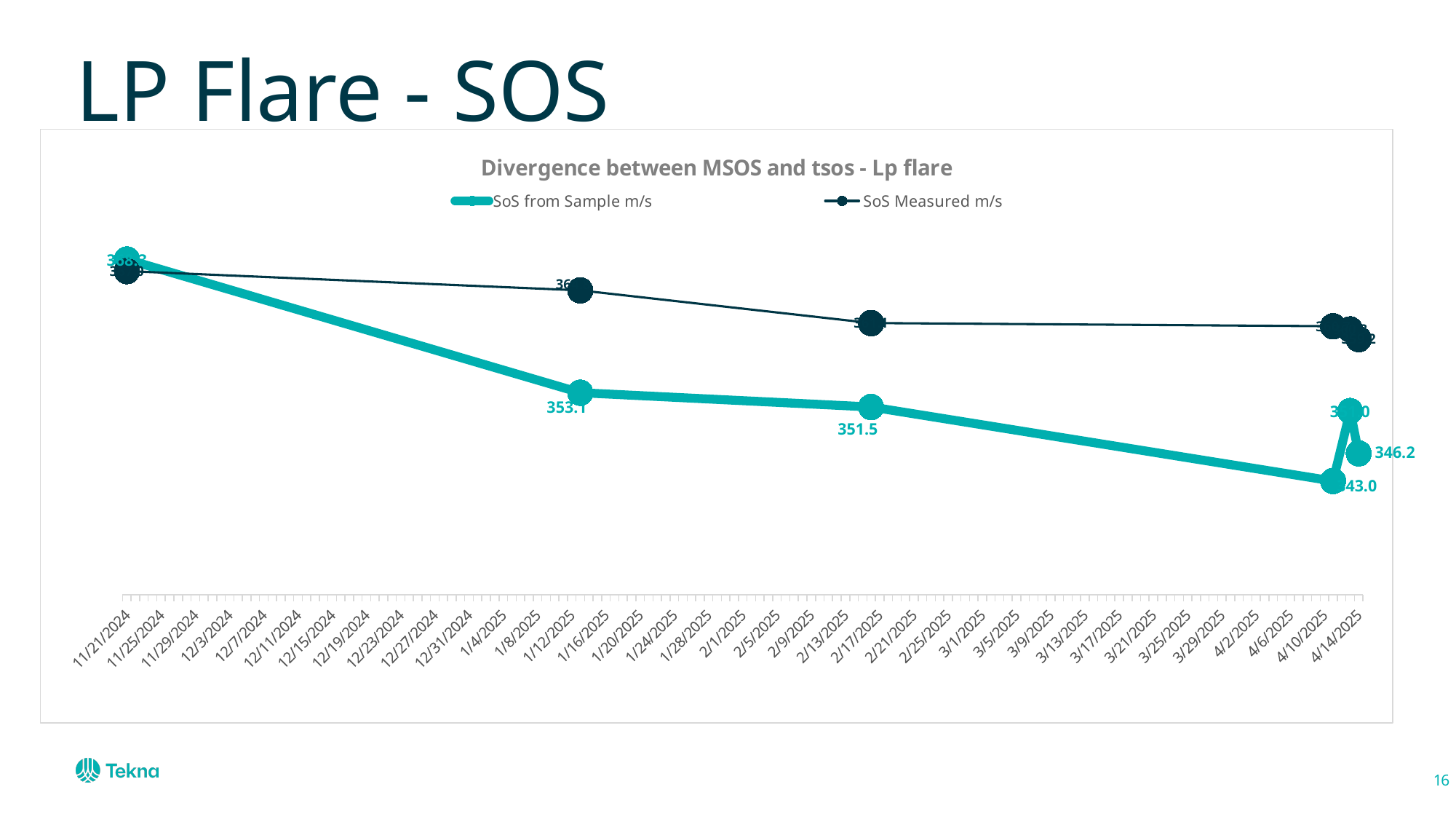
What is the title of the chart? Divergence between MSOS and tsos - Lp flare Which series is drawn in teal? SoS from Sample m/s What kind of chart is shown on the slide? Line chart Does the SoS from Sample m/s series generally rise or fall from 11/21/2024 to 4/14/2025? Fall How many series does the legend list? 2 What is the SoS from Sample m/s value labelled at 4/14/2025? 346.2 Does the SoS Measured m/s series generally rise or fall from 11/21/2024 to 4/14/2025? Fall